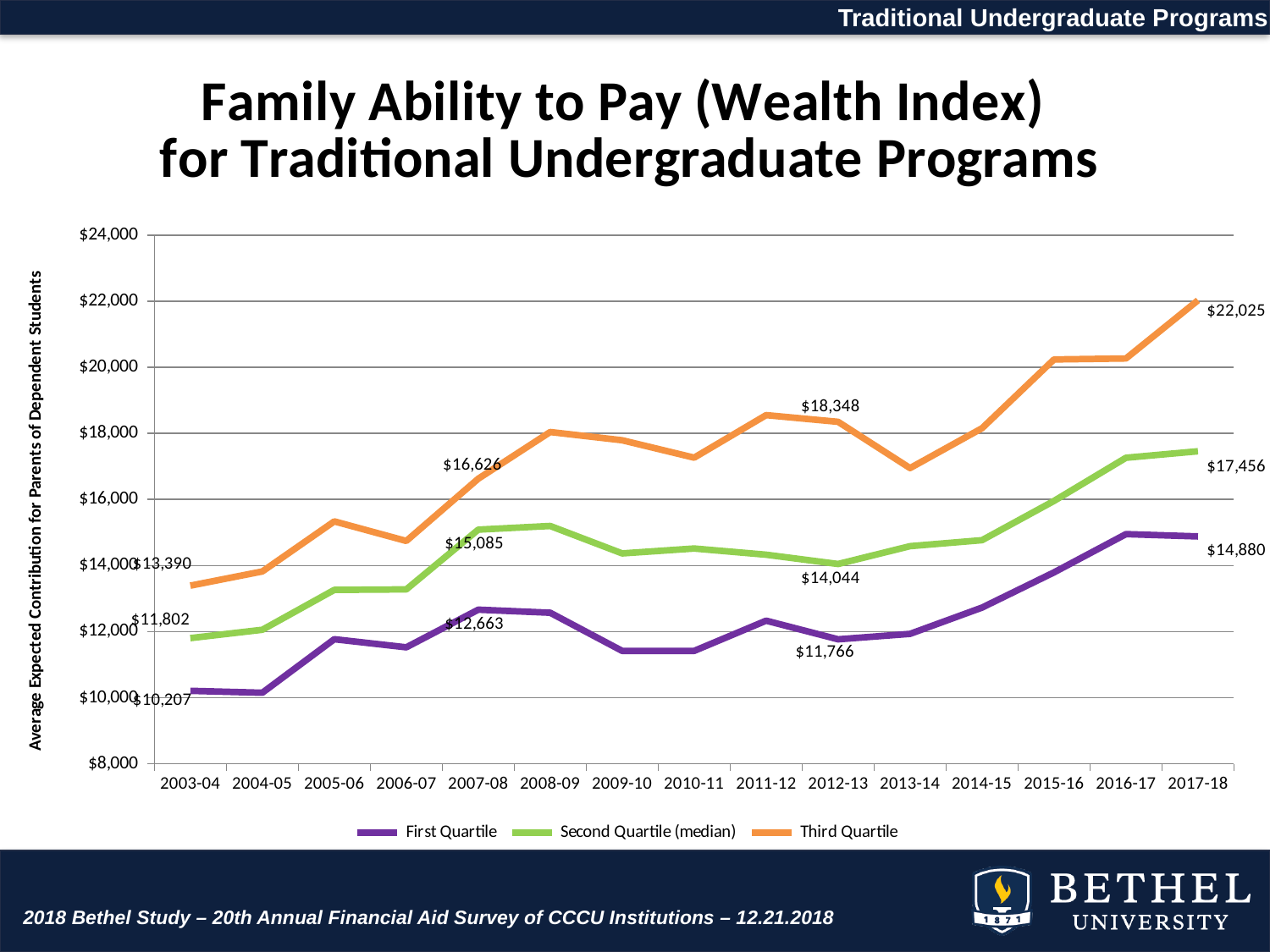
Which series has the highest value in 2017-18? Third Quartile Does the Third Quartile line generally rise or fall from 2003-04 to 2017-18? Rise What is the Third Quartile value for 2017-18? $22,025 What is the Third Quartile value for 2007-08? $16,626 What is the Second Quartile (median) value for 2012-13? $14,044 What kind of chart is shown on the slide? Line chart Is the First Quartile value for 2012-13 greater or less than $12,000? less How many series does the legend list? 3 What is the difference between the Third Quartile and First Quartile values in 2017-18? $7,145 Is the Third Quartile value for 2015-16 greater or less than $20,000? greater How many academic years are shown on the x axis? 15 What is the First Quartile value for 2003-04? $10,207